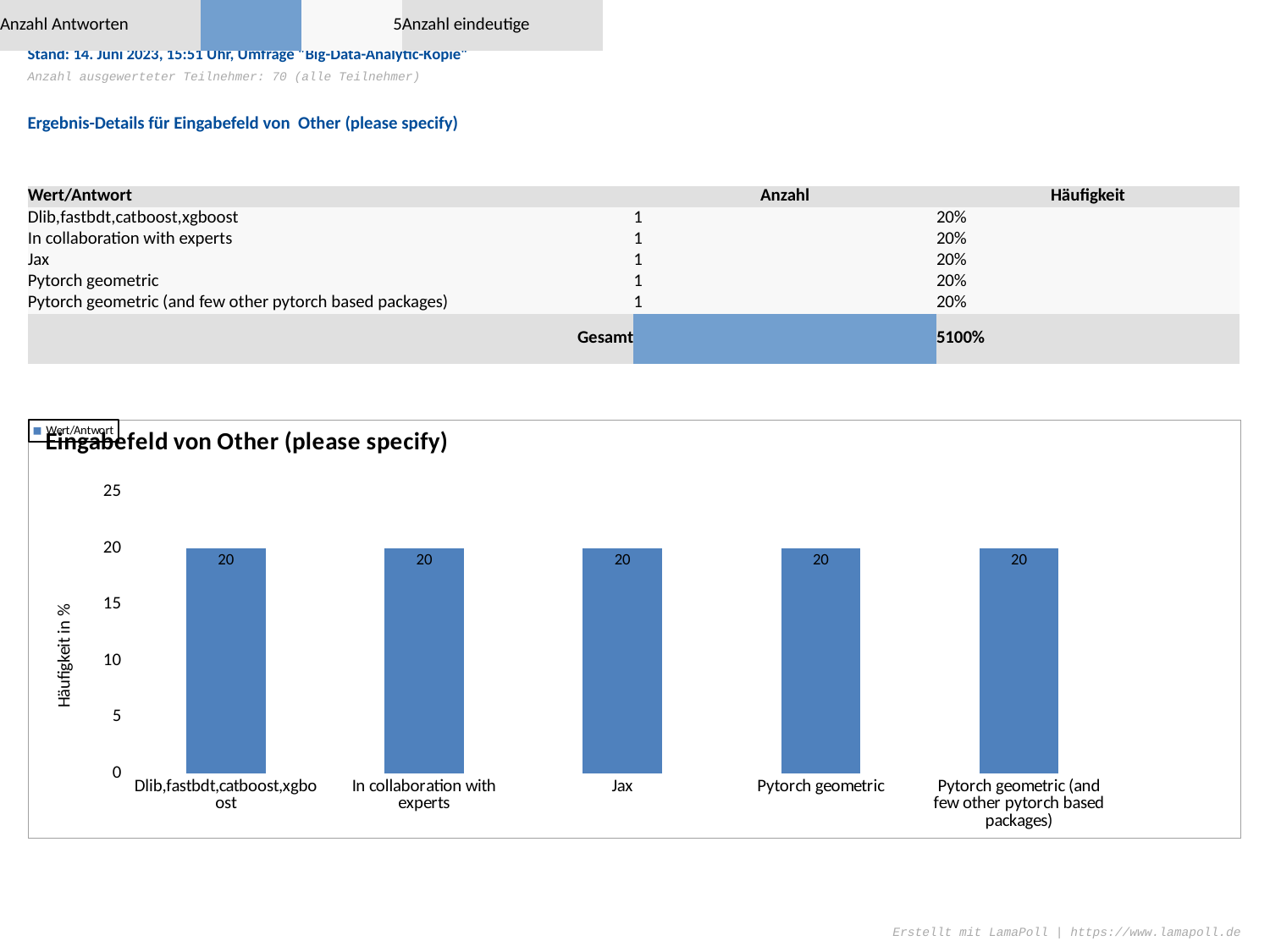
Do the values rise, fall or stay the same across the categories from left to right? stay the same How many bars (categories) does the chart show? 5 What value is shown for 'Dlib,fastbdt,catboost,xgboost' in the chart? 20 Is the value for Jax greater or less than 15? greater What value is shown for 'Pytorch geometric' in the chart? 20 How many series does the chart legend list? 1 Is the value for 'Pytorch geometric (and few other pytorch based packages)' greater or less than 25? less What is the difference between the values for Jax and 'Pytorch geometric'? 0 What kind of chart is shown on the slide? bar chart What is the title of the chart? Eingabefeld von Other (please specify) What value is shown for Jax in the chart? 20 What value is shown for the bar labelled 'In collaboration with experts'? 20